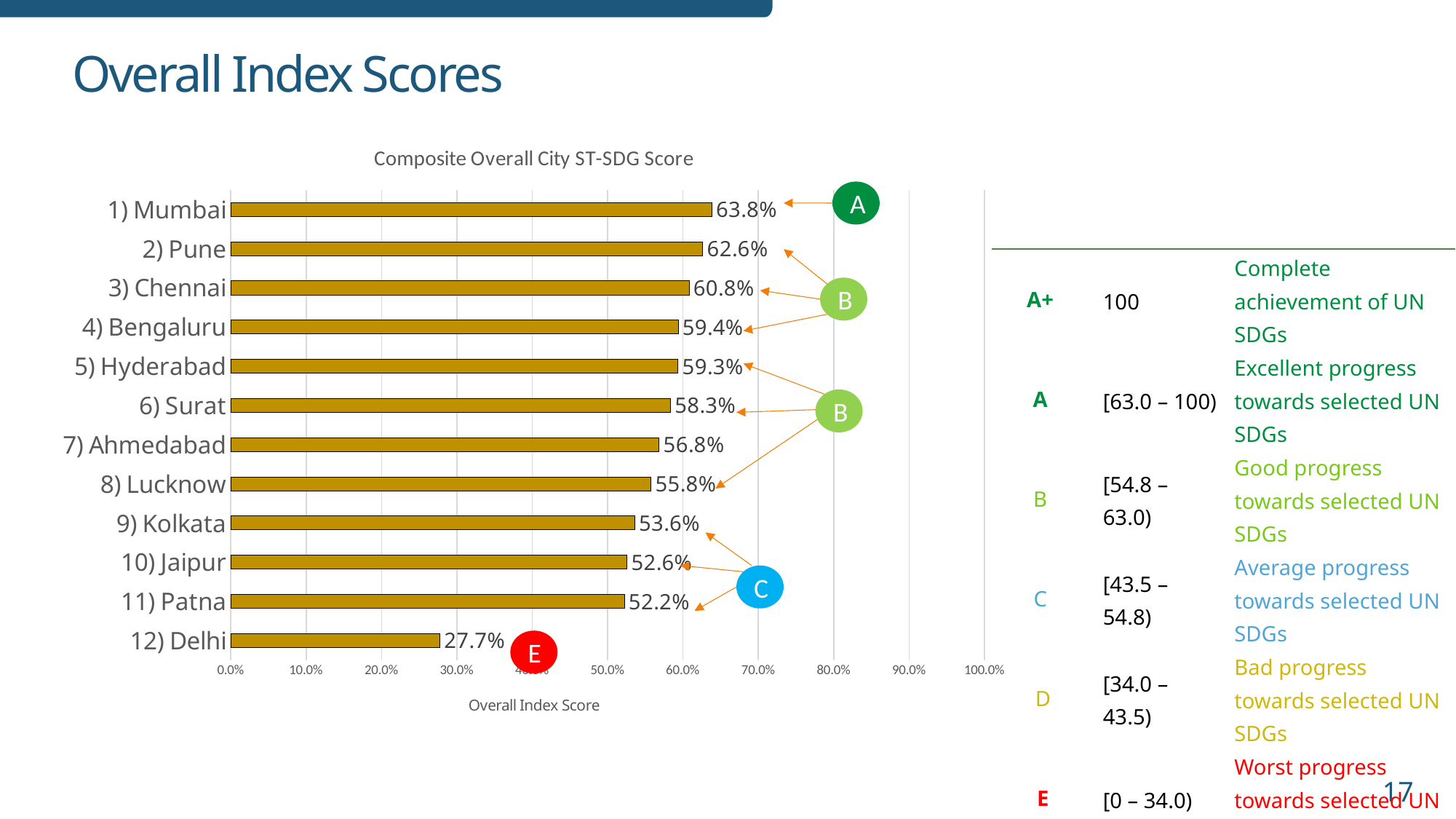
What is the value shown for Hyderabad? 59.3% What is the difference between the scores of Pune and Chennai? 1.8% What is the Composite Overall City ST-SDG Score for Mumbai? 63.8% What type of chart is used to show the Composite Overall City ST-SDG Score? Bar chart Which city has the highest Composite Overall City ST-SDG Score? Mumbai What is the Overall Index Score shown for Delhi? 27.7% What is the title of the chart? Composite Overall City ST-SDG Score Which city has the lowest Overall Index Score? Delhi Which city has a higher score, Surat or Kolkata? Surat How many cities are shown in the chart? 12 What is the difference between the scores of Mumbai and Delhi? 36.1% Is the value for Ahmedabad greater or less than 50.0%? greater